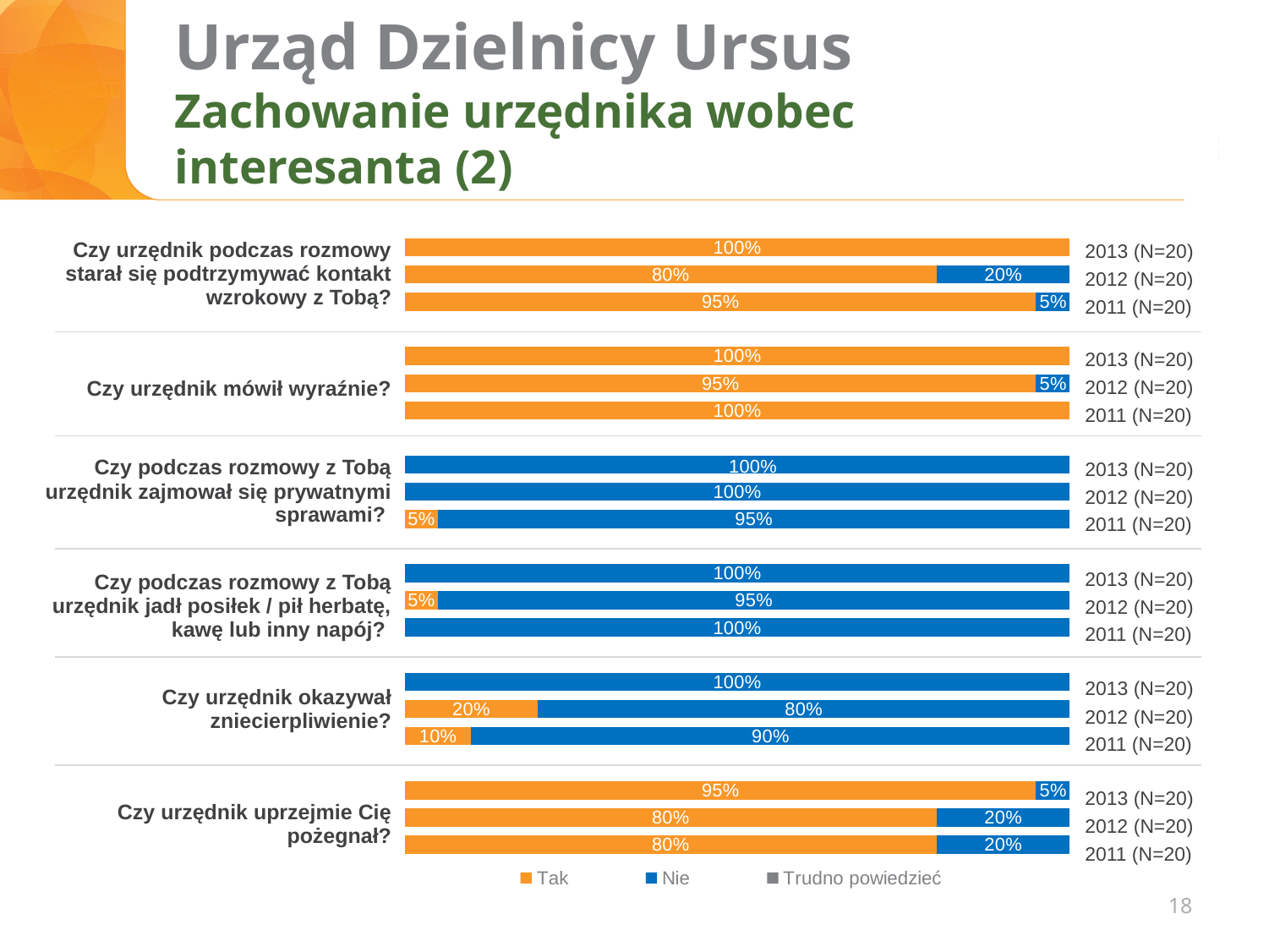
What is the 'Nie' value for 2012 (N=20) for the question 'Czy podczas rozmowy z Tobą urzędnik jadł posiłek / pił herbatę, kawę lub inny napój?'? 95% What type of chart is shown on the slide? Stacked bar chart How many series does the legend list? 3 What is the 'Nie' value for 2012 (N=20) for the question 'Czy urzędnik mówił wyraźnie?'? 5% What is the 'Tak' value for 2011 (N=20) for the question 'Czy podczas rozmowy z Tobą urzędnik zajmował się prywatnymi sprawami?'? 5% For the question 'Czy urzędnik uprzejmie Cię pożegnał?', which year has the highest 'Tak' value? 2013 (N=20) For the question 'Czy urzędnik okazywał zniecierpliwienie?', what is the difference between the 'Tak' values for 2012 (N=20) and 2011 (N=20)? 10% What are the legend entries of the chart? Tak, Nie, Trudno powiedzieć What is the 'Nie' value for 2011 (N=20) for the question 'Czy urzędnik podczas rozmowy starał się podtrzymywać kontakt wzrokowy z Tobą?'? 5% What is the 'Tak' value for 2011 (N=20) for the question 'Czy urzędnik okazywał zniecierpliwienie?'? 10% For the question 'Czy urzędnik uprzejmie Cię pożegnał?', is the 'Nie' value for 2012 (N=20) larger or smaller than the 'Nie' value for 2013 (N=20)? Larger What is the 'Tak' value for 2012 (N=20) for the question 'Czy urzędnik podczas rozmowy starał się podtrzymywać kontakt wzrokowy z Tobą?'? 80%